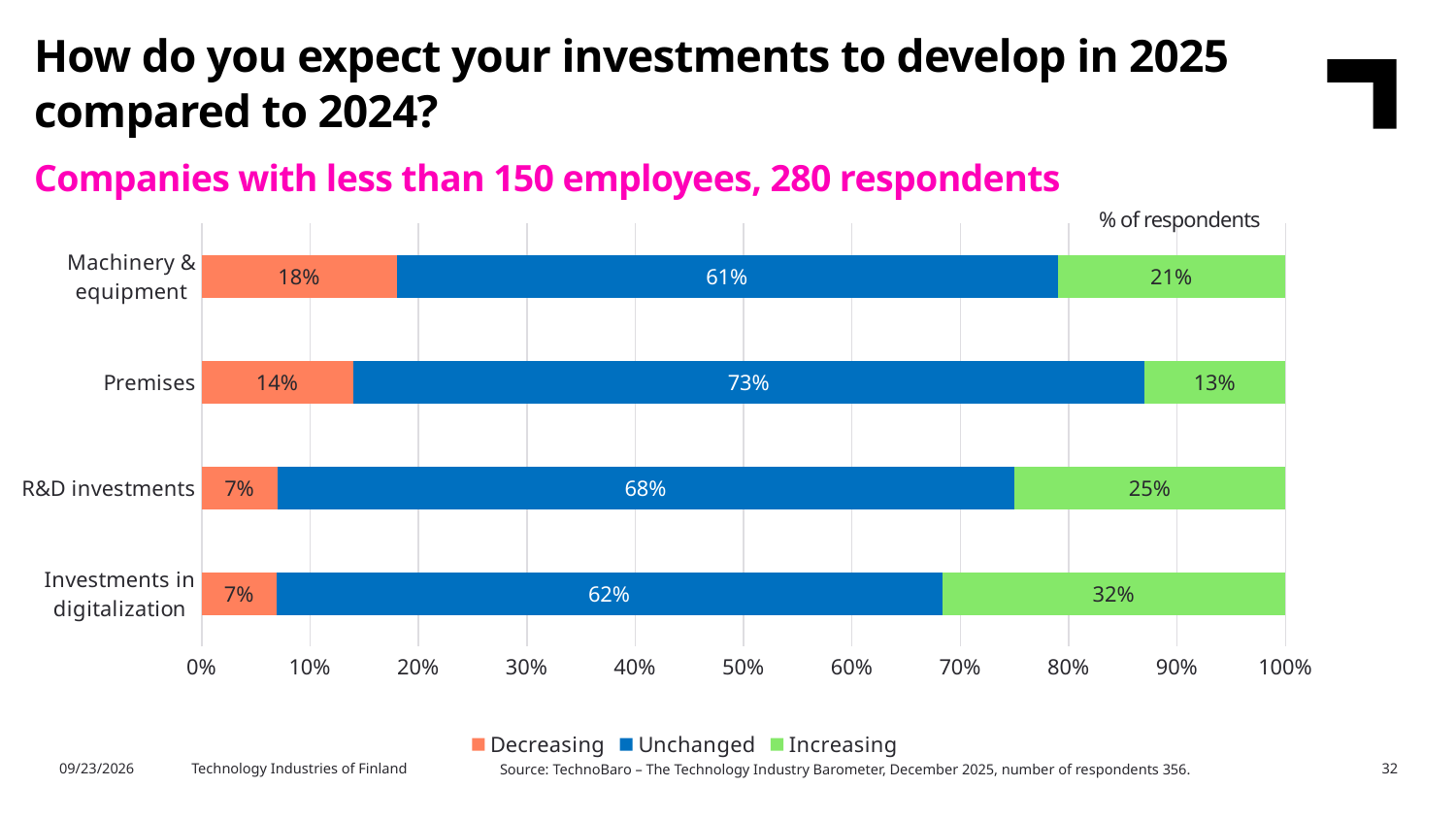
How many investment categories are shown in the chart? 4 Which category has the lowest share of respondents expecting an increase? Premises What percentage of respondents expect investments in digitalization to be increasing? 32% What kind of chart is shown on the slide? Stacked bar chart What percentage of respondents expect machinery & equipment investments to be decreasing? 18% What percentage of respondents expect premises investments to remain unchanged? 73% What is the difference between the 'Increasing' share for R&D investments and for premises? 12 percentage points Which category has the highest share of respondents expecting an increase? Investments in digitalization Which has a larger 'Decreasing' share: machinery & equipment or premises? Machinery & equipment Which legend entry is shown in green? Increasing How many series does the legend list? 3 What is the total of the three segments for the R&D investments bar? 100%